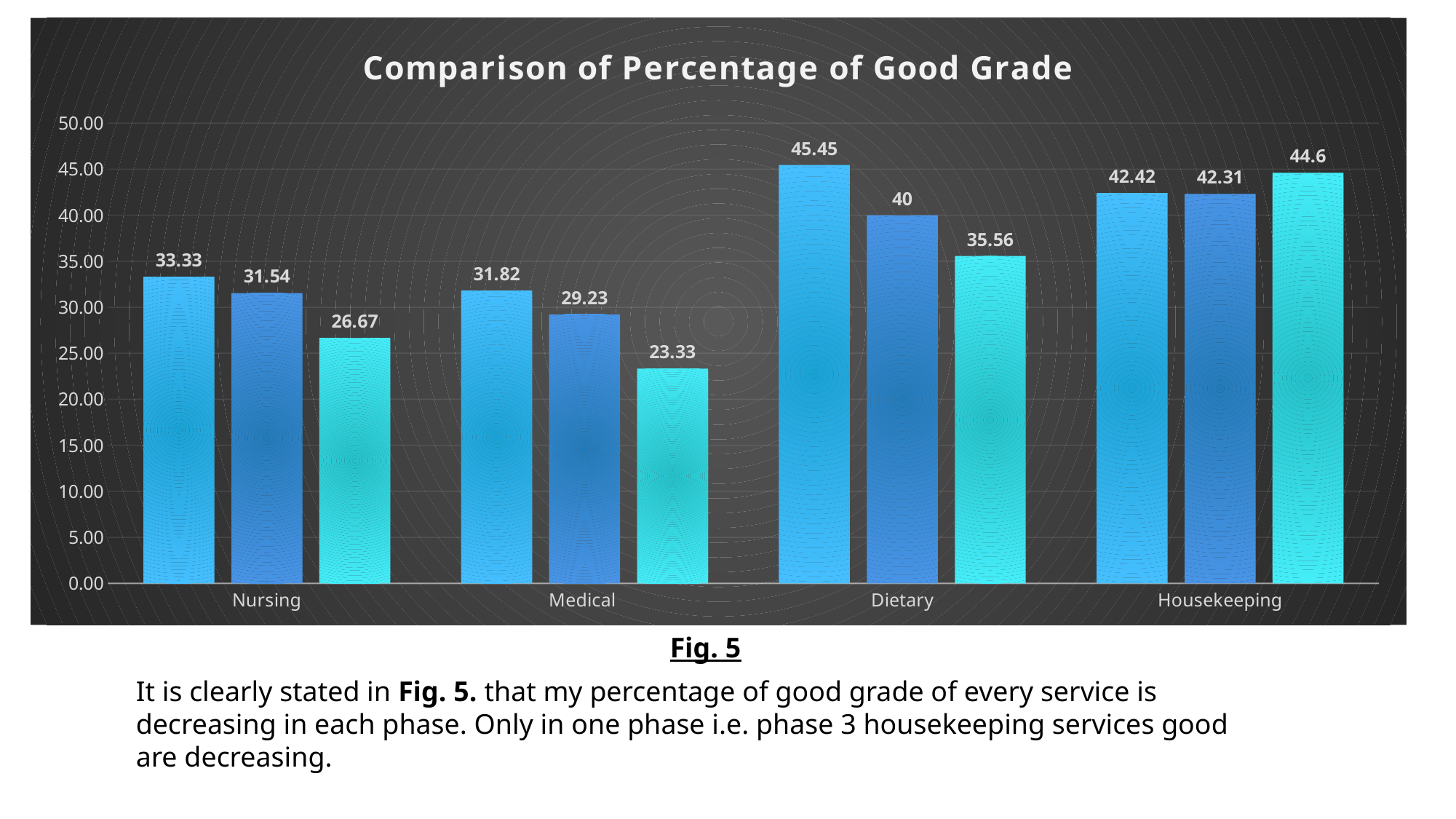
Do the three bars for Nursing rise or fall from left to right? fall What is the value of the first (leftmost) bar for Dietary? 45.45 Which category contains the lowest bar in the chart? Medical What kind of chart is shown on the slide? bar chart Which is larger: the middle bar for Dietary or the middle bar for Housekeeping? Housekeeping What is the value of the second (middle) bar for Medical? 29.23 What is the title of the chart? Comparison of Percentage of Good Grade How many bars are plotted for each category in the chart? 3 How many categories are shown on the x axis of the chart? 4 What is the difference between the first and third bars for Nursing? 6.66 Which category contains the highest bar in the chart? Dietary What is the value of the third (rightmost) bar for Housekeeping? 44.6